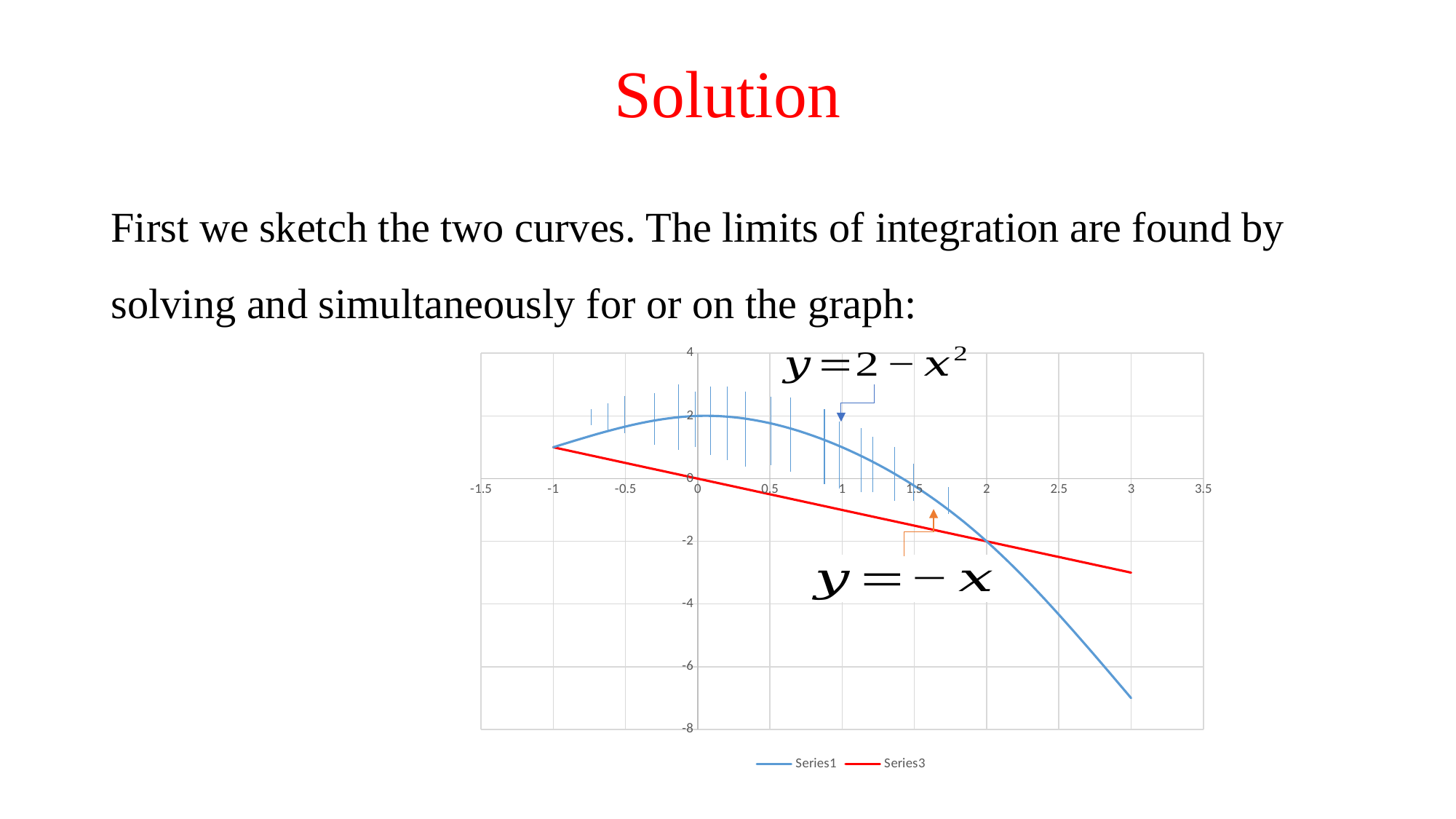
Is the value of Series1 at x = 3 greater or less than -6? less What kind of chart is shown on the slide? line chart Is the value of Series3 at x = 3 greater or less than -2? less What is the highest value reached by Series1? 2 At x = 0, which series has the larger value, Series1 or Series3? Series1 Does the value of Series3 rise or fall as x increases? fall At x = 3, which series has the larger value, Series1 or Series3? Series3 How many series does the legend list? 2 Is the value of Series1 at x = 0.5 greater or less than 0? greater What are the names of the series listed in the legend? Series1 and Series3 At which x value on the right side of the chart do Series1 and Series3 cross? 2 What colour is the line for Series3? red